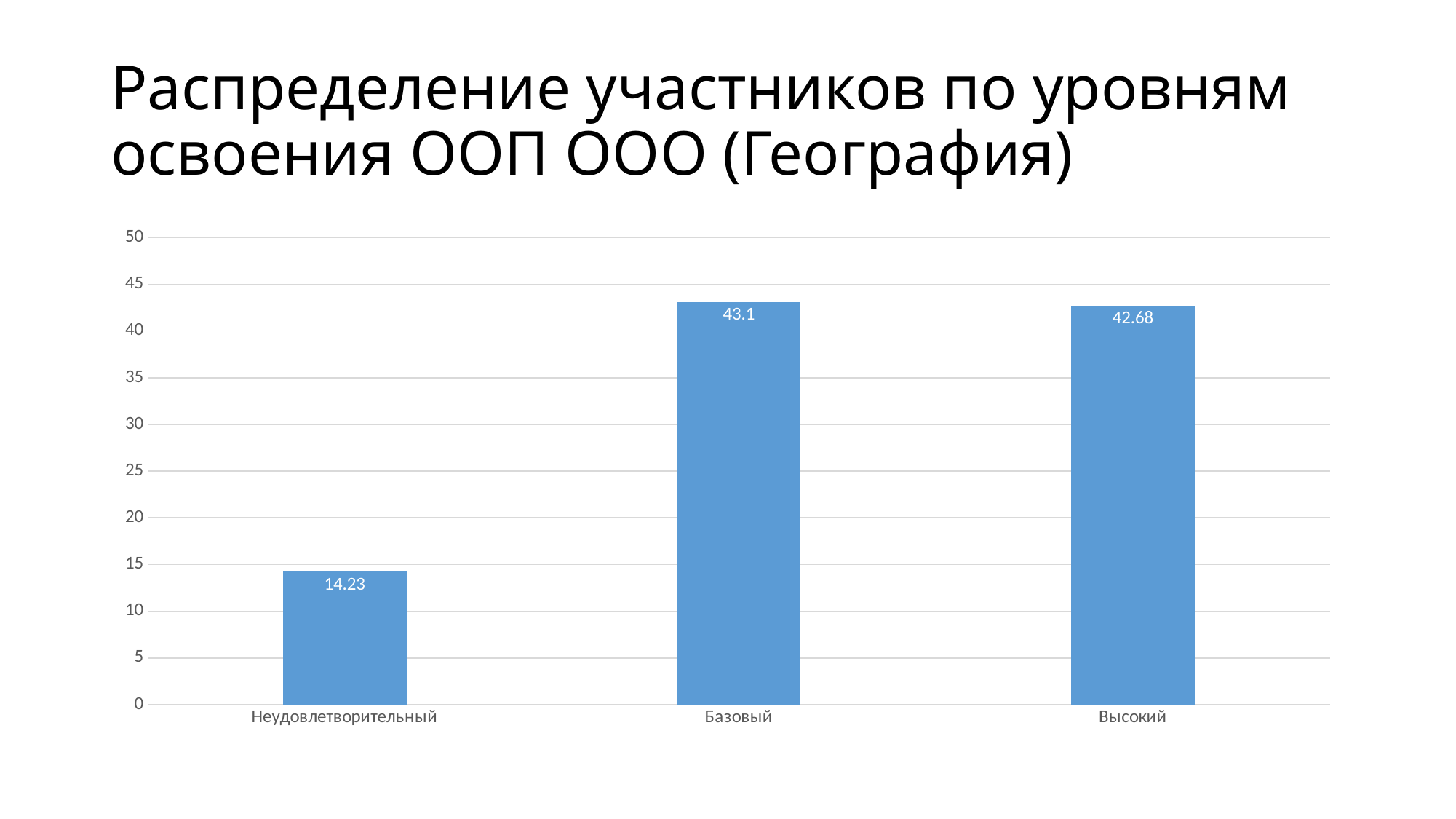
What is the value for Базовый? 43.1 What is the difference between the values for Высокий and Неудовлетворительный? 28.45 What is the value for Высокий? 42.68 What kind of chart is shown on the slide? bar chart Which is larger, the value for Базовый or the value for Высокий? Базовый What is the title of the slide? Распределение участников по уровням освоения ООП ООО (География) How many categories are shown on the x axis? 3 What is the difference between the values for Базовый and Неудовлетворительный? 28.87 Which category has the lowest value? Неудовлетворительный Which category has the highest value? Базовый What is the value for Неудовлетворительный? 14.23 Is the value for Неудовлетворительный greater or less than 15? less